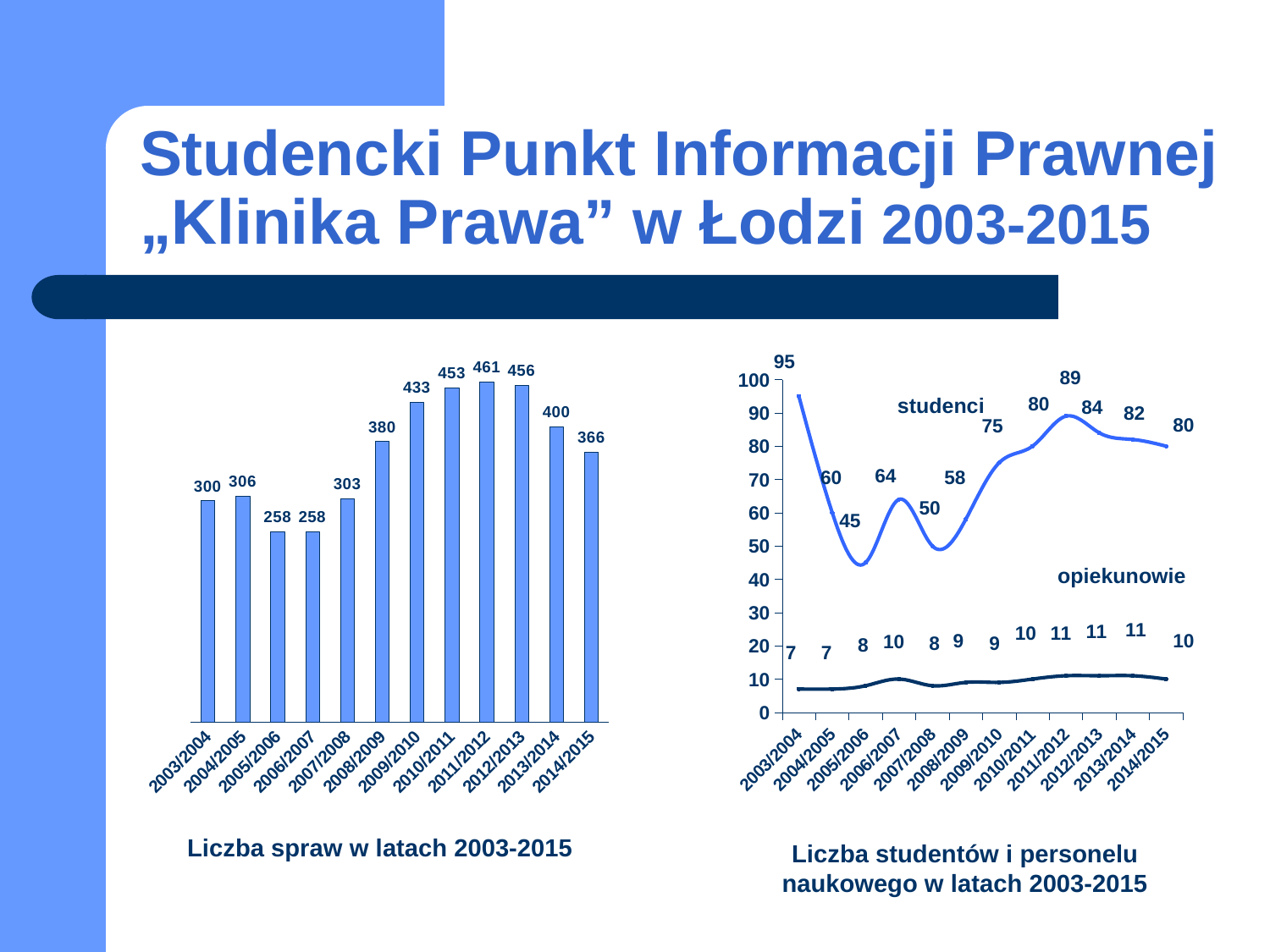
In the chart 'Liczba spraw w latach 2003-2015', what is the lowest value shown? 258 In the chart 'Liczba studentów i personelu naukowego w latach 2003-2015', what is the value for opiekunowie in 2011/2012? 11 In the chart 'Liczba spraw w latach 2003-2015', what is the value for 2009/2010? 433 In the chart 'Liczba spraw w latach 2003-2015', how many years are shown on the x axis? 12 What kind of chart is 'Liczba studentów i personelu naukowego w latach 2003-2015'? line chart In the chart 'Liczba spraw w latach 2003-2015', which year has the highest value? 2011/2012 What kind of chart is 'Liczba spraw w latach 2003-2015'? bar chart In the chart 'Liczba studentów i personelu naukowego w latach 2003-2015', in which year is the studenci value highest? 2003/2004 In the chart 'Liczba studentów i personelu naukowego w latach 2003-2015', what is the value for studenci in 2005/2006? 45 In the chart 'Liczba spraw w latach 2003-2015', what is the difference between the values for 2011/2012 and 2014/2015? 95 In the chart 'Liczba studentów i personelu naukowego w latach 2003-2015', what is the difference between studenci and opiekunowie in 2014/2015? 70 In the chart 'Liczba studentów i personelu naukowego w latach 2003-2015', which is larger: studenci in 2006/2007 or studenci in 2007/2008? 2006/2007